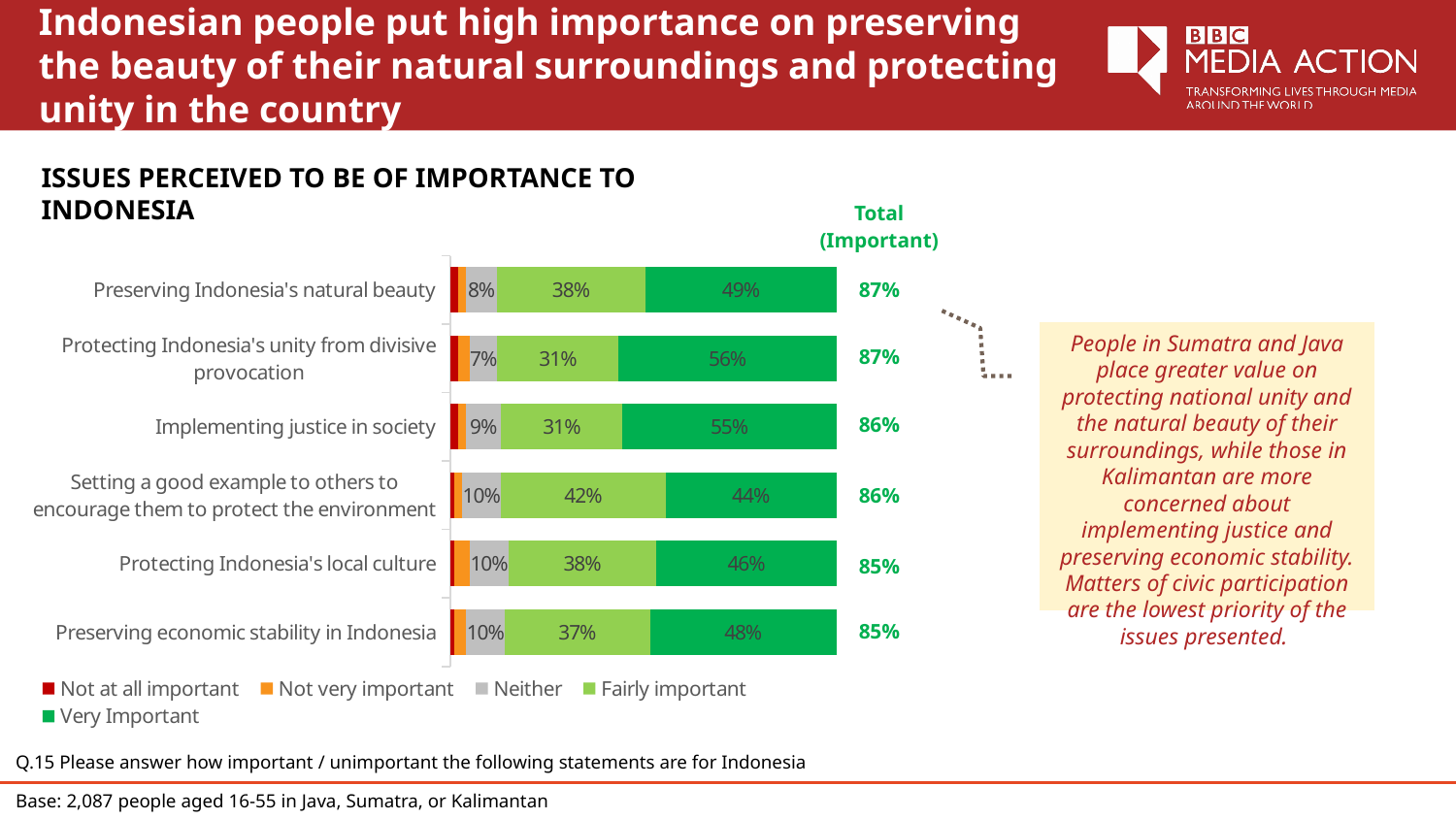
What is the difference between the Very Important percentages for 'Protecting Indonesia's unity from divisive provocation' and 'Preserving Indonesia's natural beauty'? 7 percentage points What is the Total (Important) figure for 'Protecting Indonesia's local culture'? 85% Which issue has the lowest Very Important percentage? Setting a good example to others to encourage them to protect the environment What kind of chart is shown on the slide? Stacked bar chart What percentage rated 'Setting a good example to others to encourage them to protect the environment' as Fairly important? 42% Which issue has the highest Very Important percentage? Protecting Indonesia's unity from divisive provocation Which has a larger Fairly important percentage: 'Preserving Indonesia's natural beauty' or 'Implementing justice in society'? Preserving Indonesia's natural beauty How many issues (categories) are plotted in the chart? 6 What is the title of the chart? ISSUES PERCEIVED TO BE OF IMPORTANCE TO INDONESIA What is the Neither percentage for 'Preserving economic stability in Indonesia'? 10% How many series does the legend list? 5 What percentage rated 'Protecting Indonesia's unity from divisive provocation' as Very Important? 56%